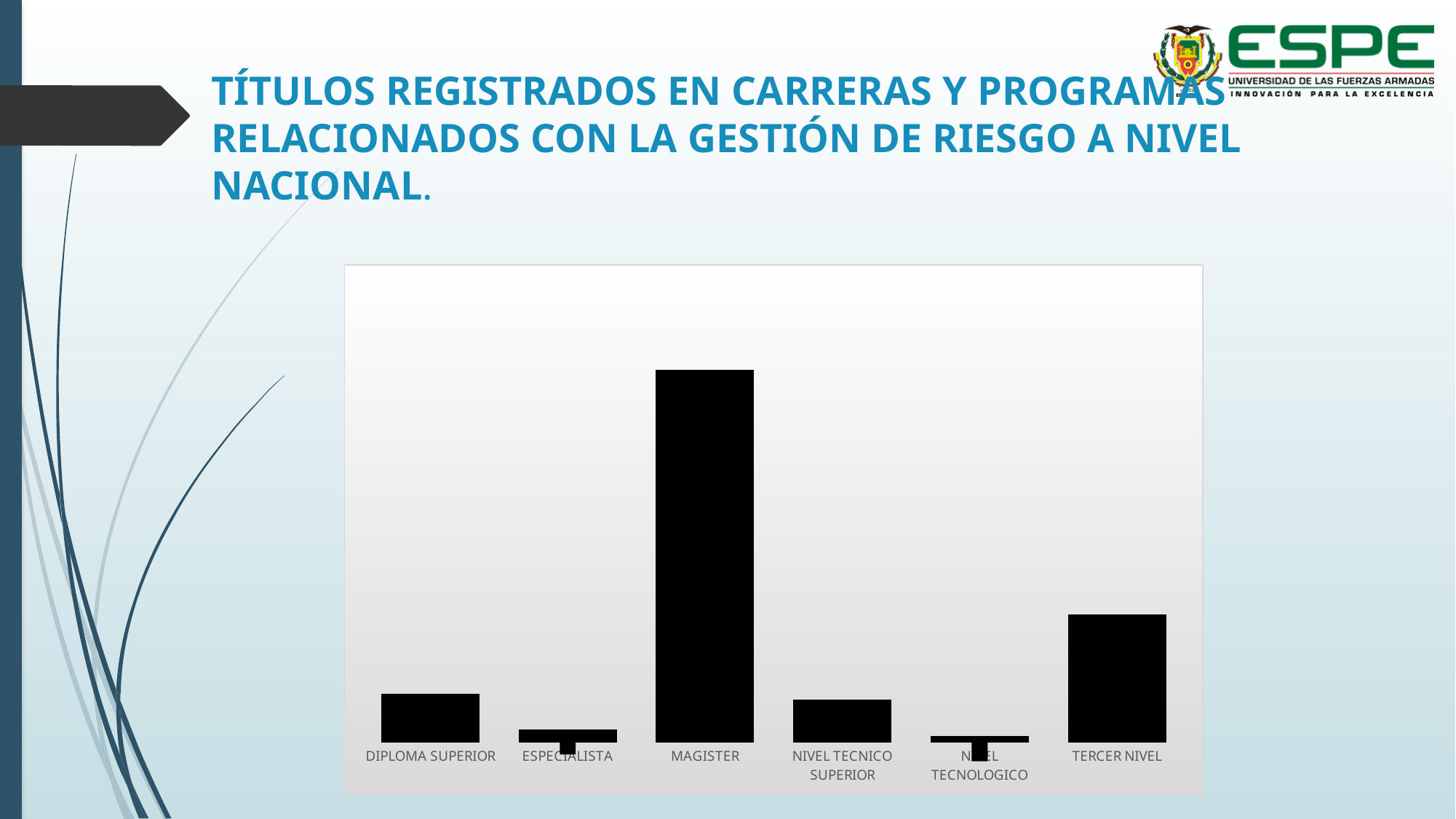
Which category has the second highest bar in the chart? TERCER NIVEL Which is larger, the value for TERCER NIVEL or the value for DIPLOMA SUPERIOR? TERCER NIVEL What kind of chart is shown on the slide? bar chart How many categories are plotted in the chart? 6 What is the label of the first category on the left of the chart? DIPLOMA SUPERIOR Which category has the lowest bar in the chart? NIVEL TECNOLOGICO Which is larger, the value for ESPECIALISTA or the value for NIVEL TECNOLOGICO? ESPECIALISTA Which is larger, the value for MAGISTER or the value for TERCER NIVEL? MAGISTER What colour are the bars in the chart? black Which category has the highest bar in the chart? MAGISTER